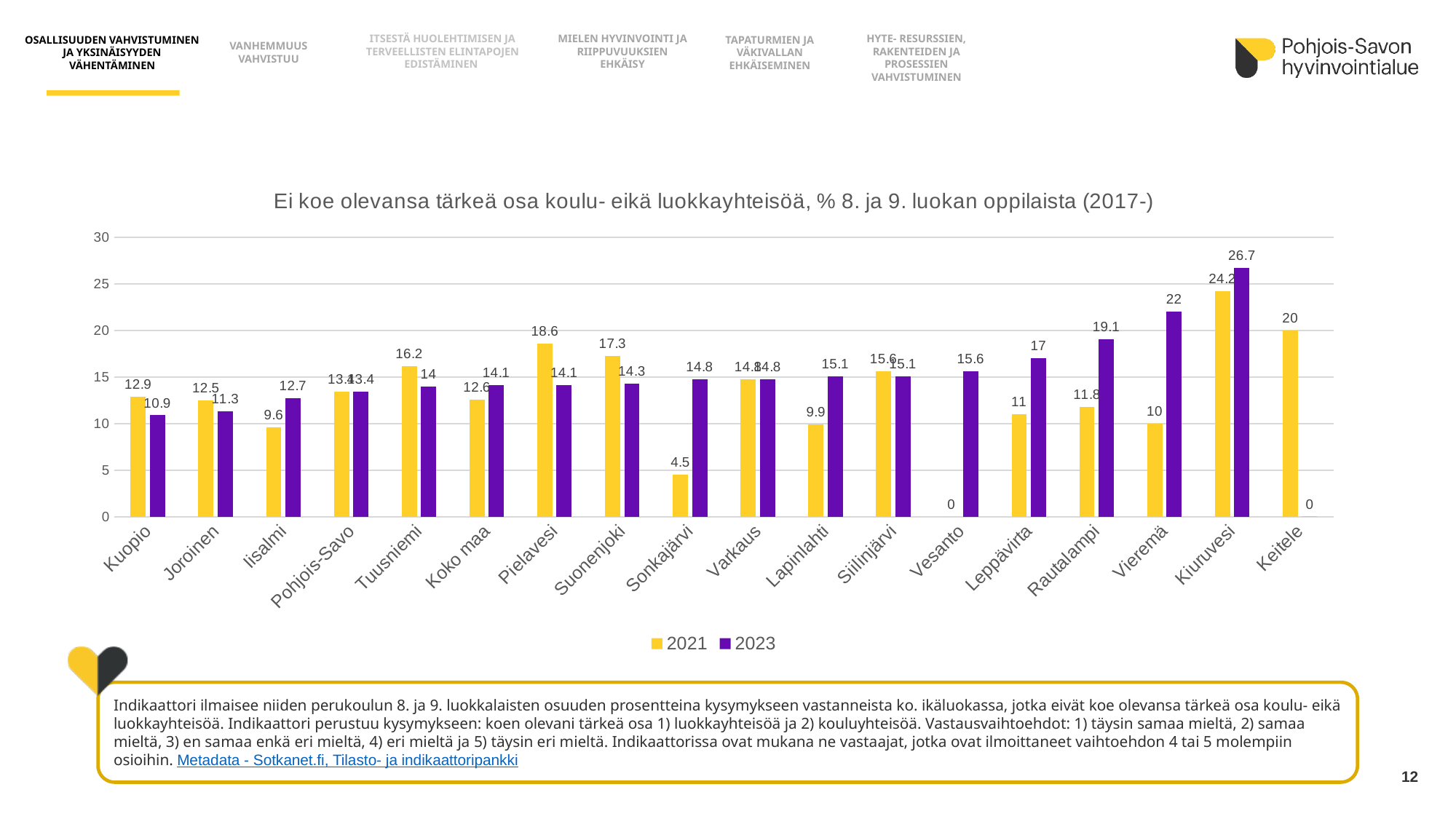
How many categories are shown on the x axis? 18 What is the 2021 value for Sonkajärvi? 4.5 Is the 2023 value for Vieremä greater or less than 20? greater Which category has the highest 2021 value? Kiuruvesi What kind of chart is shown on the slide? bar chart What is the 2023 value for Rautalampi? 19.1 Which is larger: the 2021 value for Pielavesi or the 2021 value for Suonenjoki? Pielavesi What is the 2021 value for Pielavesi? 18.6 What is the difference between the 2023 and 2021 values for Kiuruvesi? 2.5 How many series does the legend list? 2 Which two series are listed in the legend? 2021 and 2023 Which category has the highest 2023 value? Kiuruvesi